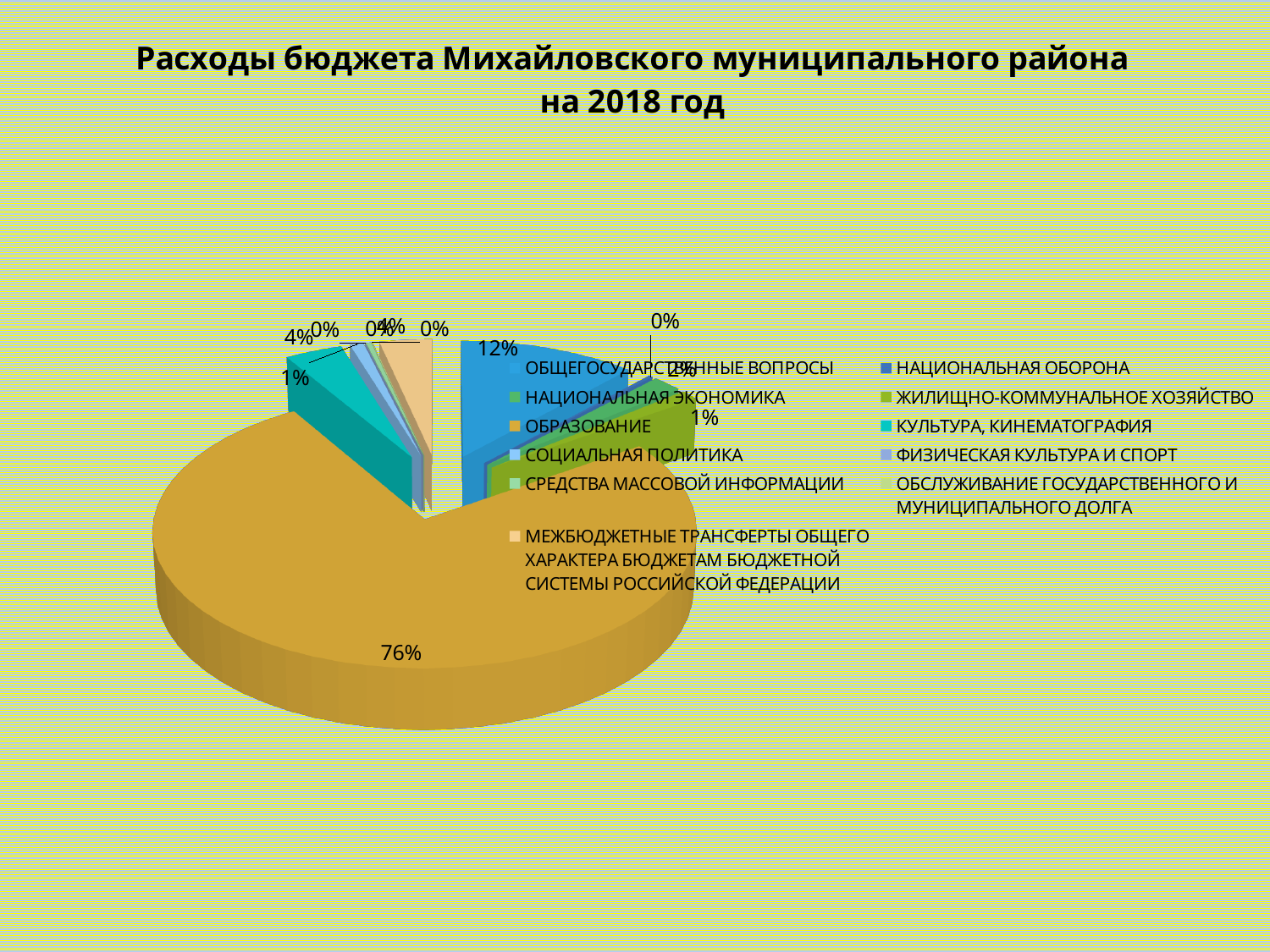
Is the share for ОБЩЕГОСУДАРСТВЕННЫЕ ВОПРОСЫ greater or less than 20%? less What kind of chart is shown on the slide? pie chart What colour is the slice for ОБРАЗОВАНИЕ? orange Which category has the largest share of the pie? ОБРАЗОВАНИЕ What percentage is shown for ОБЩЕГОСУДАРСТВЕННЫЕ ВОПРОСЫ? 12% Which is larger: the share for ОБРАЗОВАНИЕ or the share for ОБЩЕГОСУДАРСТВЕННЫЕ ВОПРОСЫ? ОБРАЗОВАНИЕ By how many percentage points does the share for ОБРАЗОВАНИЕ exceed the share for ОБЩЕГОСУДАРСТВЕННЫЕ ВОПРОСЫ? 64 percentage points What is the title of the chart? Расходы бюджета Михайловского муниципального района на 2018 год Is the share for ОБРАЗОВАНИЕ greater or less than 50%? greater How many categories does the legend list? 11 What share of the budget expenditures goes to ОБРАЗОВАНИЕ? 76%